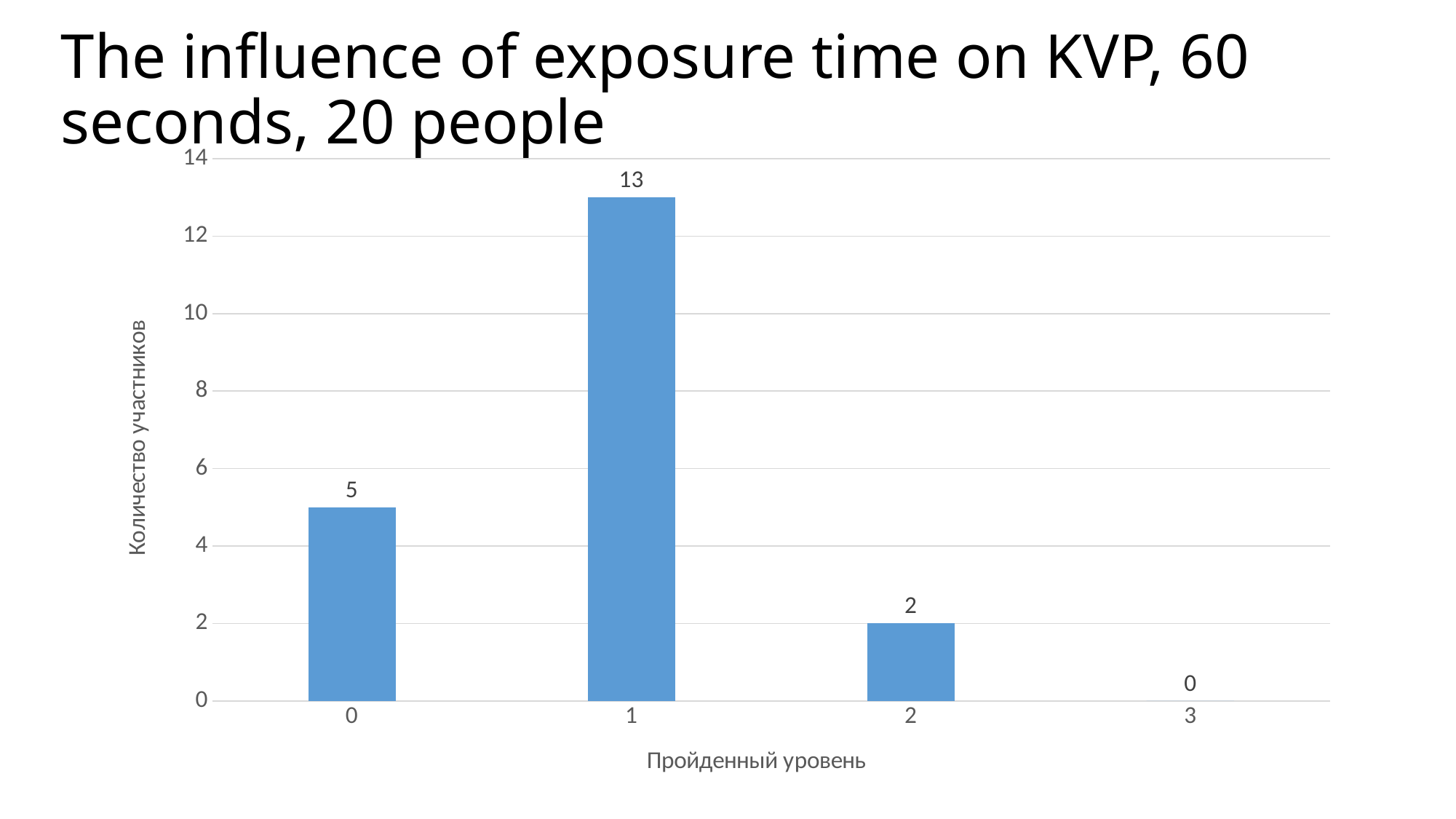
Is the value for level 1 greater or less than 10? greater What is the difference between the values for level 1 and level 0? 8 What kind of chart is shown on the slide? bar chart What is the value for level 2? 2 How many categories are shown on the x axis? 4 Which level has the highest number of participants? 1 What is the value for level 3? 0 What is the value for level 1? 13 What is the value for level 0? 5 What is the title of the chart on the slide? The influence of exposure time on KVP, 60 seconds, 20 people Which level has the lowest number of participants? 3 Which is larger, the value for level 0 or the value for level 2? level 0